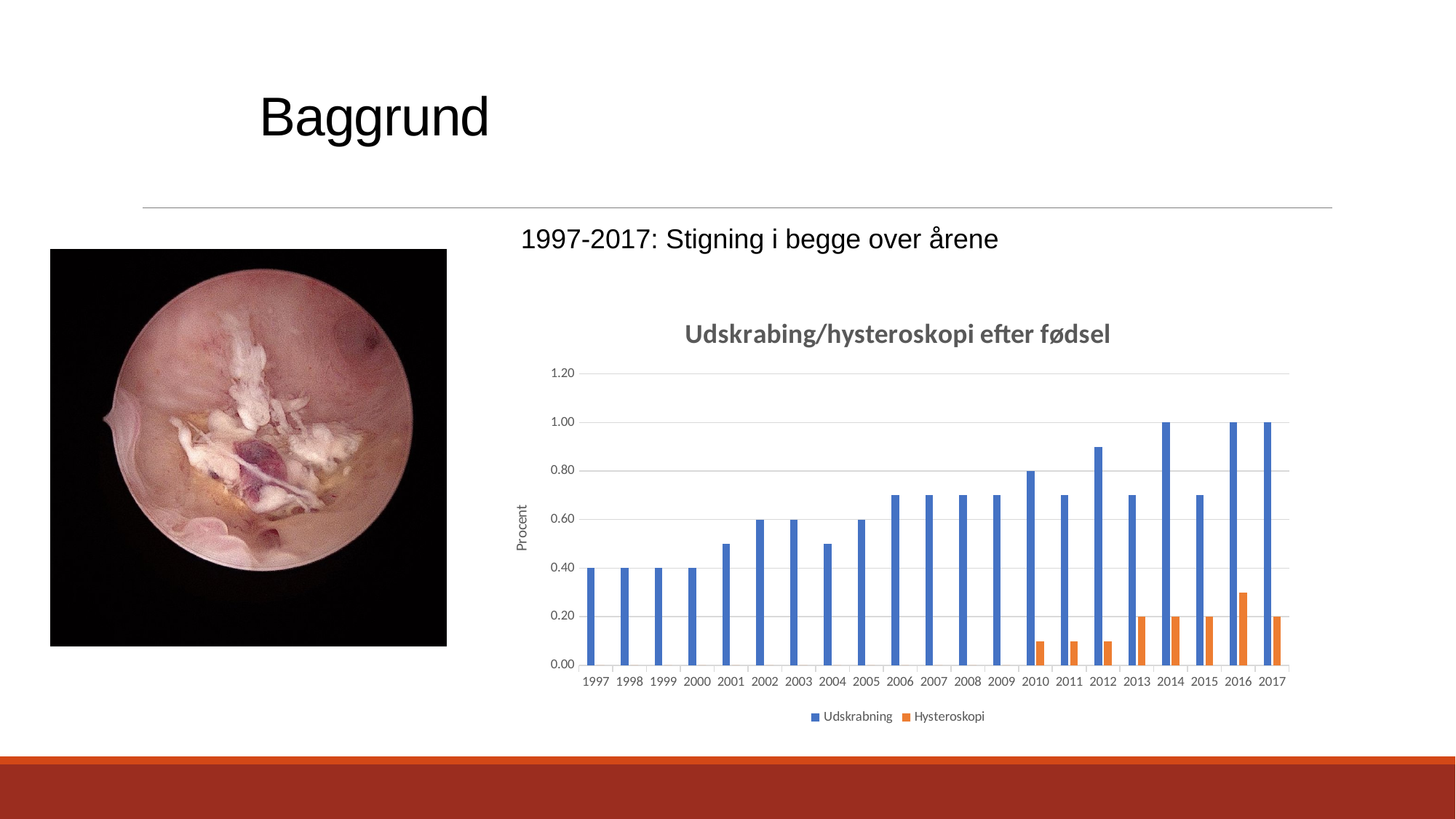
How many series does the chart legend list? 2 What is the value for Udskrabning in 2014? 1.00 Which is larger in 2017, Udskrabning or Hysteroskopi? Udskrabning In which year is the Hysteroskopi value highest? 2016 What is the title of the chart? Udskrabing/hysteroskopi efter fødsel What is the value for Udskrabning in 1997? 0.40 What kind of chart is shown on the slide? bar chart What is the value for Hysteroskopi in 2013? 0.20 What is the difference between the Udskrabning value in 2010 and in 1997? 0.40 Is the value for Udskrabning in 2012 greater or less than 0.80? greater How many years are shown on the x axis of the chart? 21 Is the value for Udskrabning in 2001 greater or less than 0.60? less